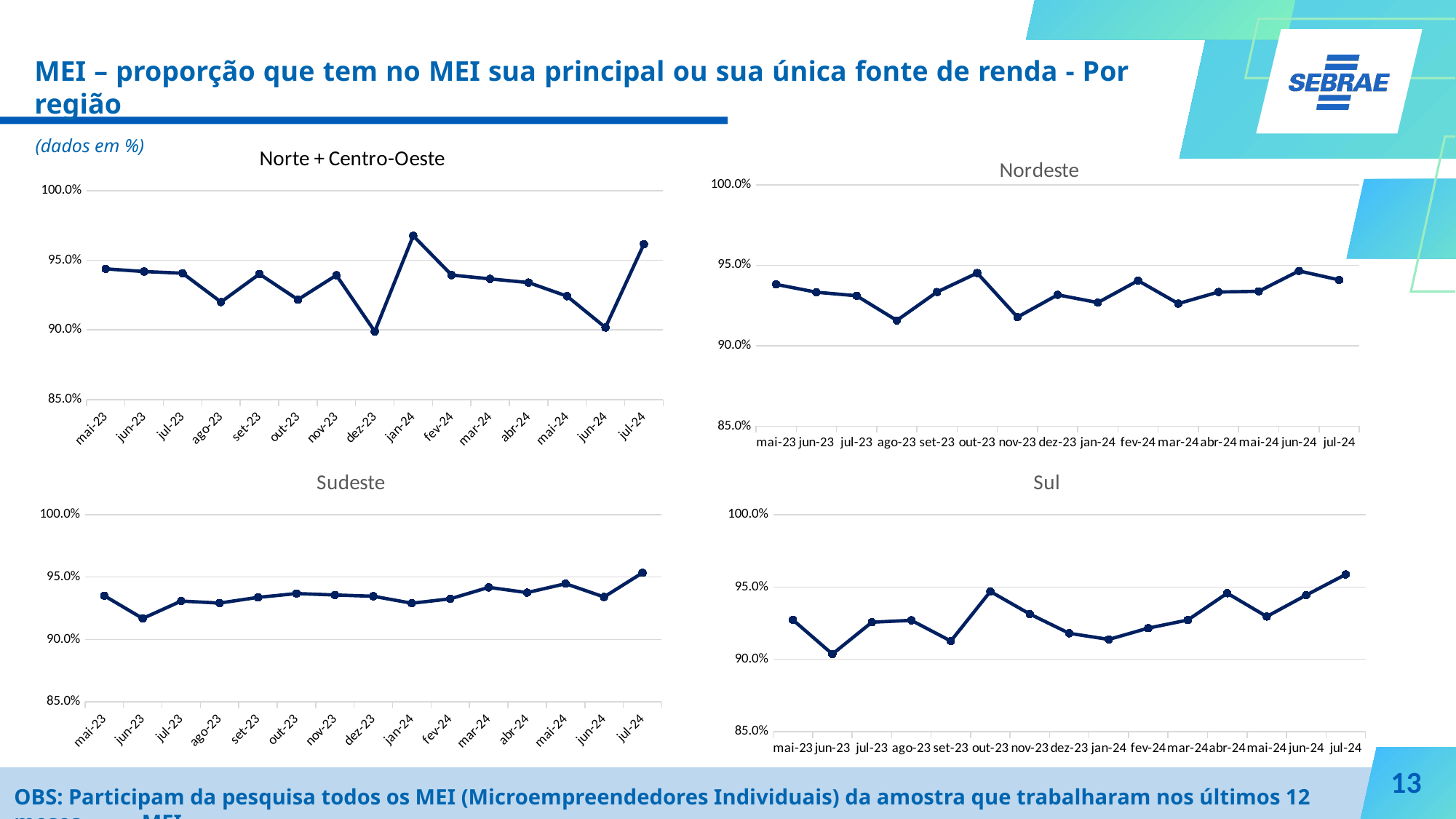
In the 'Sudeste' chart, which month has the lowest value? jun-23 What is the title of the chart in the top-right position of the slide? Nordeste In the 'Sudeste' chart, which month has the highest value? jul-24 In the 'Nordeste' chart, is the value for ago-23 greater or less than 95.0%? less In the 'Norte + Centro-Oeste' chart, is the value for jan-24 greater or less than 95.0%? greater What kind of chart is the 'Sudeste' chart? line chart How many data points are plotted in the 'Norte + Centro-Oeste' chart? 15 In the 'Sul' chart, which month has the lowest value? jun-23 In the 'Sul' chart, is the value for jul-24 greater or less than 95.0%? greater In the 'Sul' chart, which is larger, the value for jul-24 or the value for mai-23? jul-24 In the 'Sul' chart, do the values rise or fall from out-23 to jan-24? fall In the 'Norte + Centro-Oeste' chart, which month has the highest value? jan-24